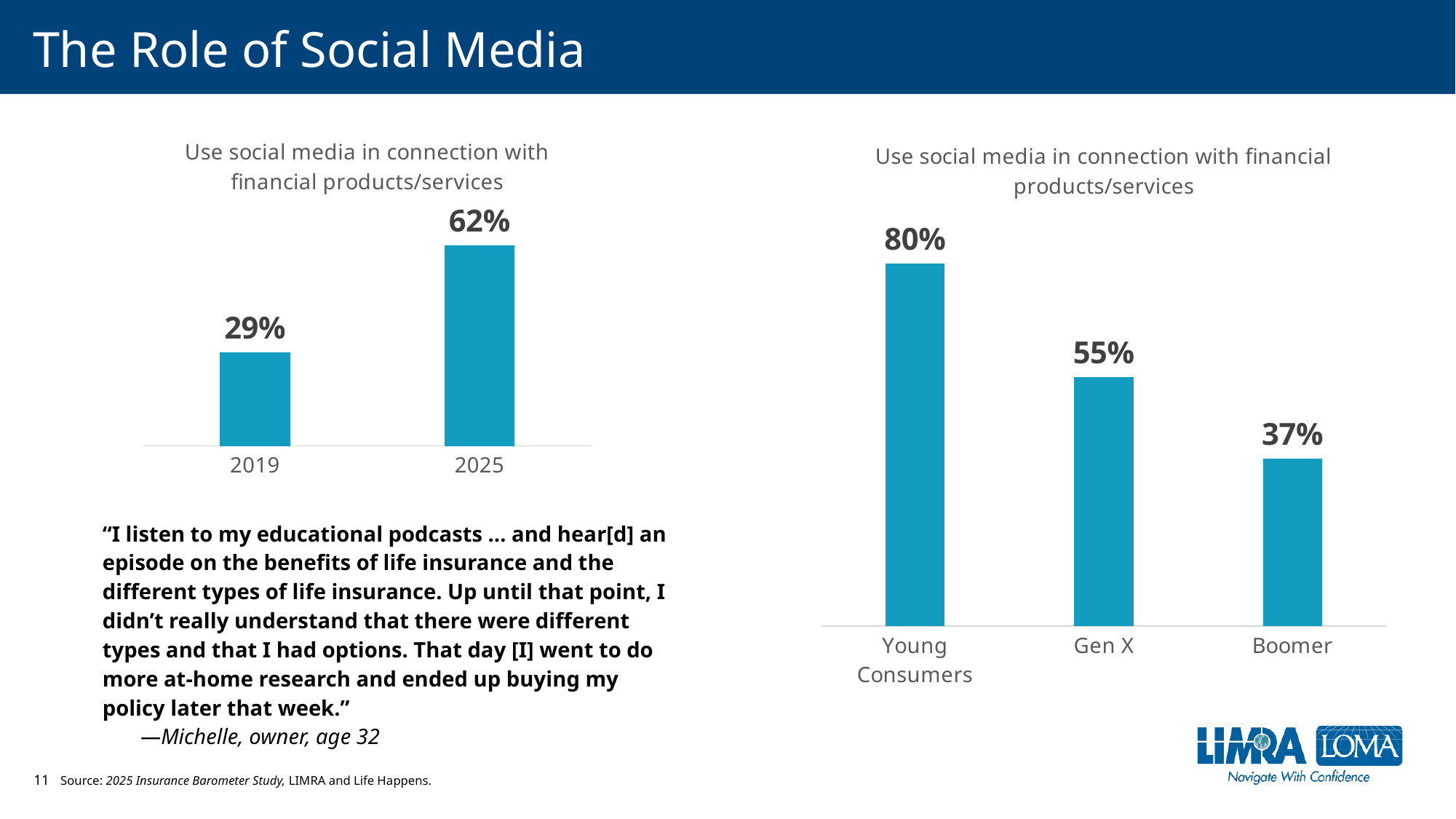
In the left chart (2019 vs 2025), how many categories are plotted? 2 In the right chart (by generation), which category has the highest value? Young Consumers In the left chart (2019 vs 2025), what is the value for 2019? 29% In the right chart (by generation), what is the value for Gen X? 55% In the left chart (2019 vs 2025), do the values rise or fall from 2019 to 2025? rise In the right chart (by generation), what is the value for Boomer? 37% In the right chart (by generation), what is the value for Young Consumers? 80% In the right chart (by generation), what is the difference between Young Consumers and Gen X? 25 percentage points In the right chart (by generation), which category has the lowest value? Boomer In the left chart (2019 vs 2025), by how many percentage points did the value increase from 2019 to 2025? 33 percentage points In the left chart (2019 vs 2025), what is the value for 2025? 62% What type of chart is the right chart (by generation)? bar chart